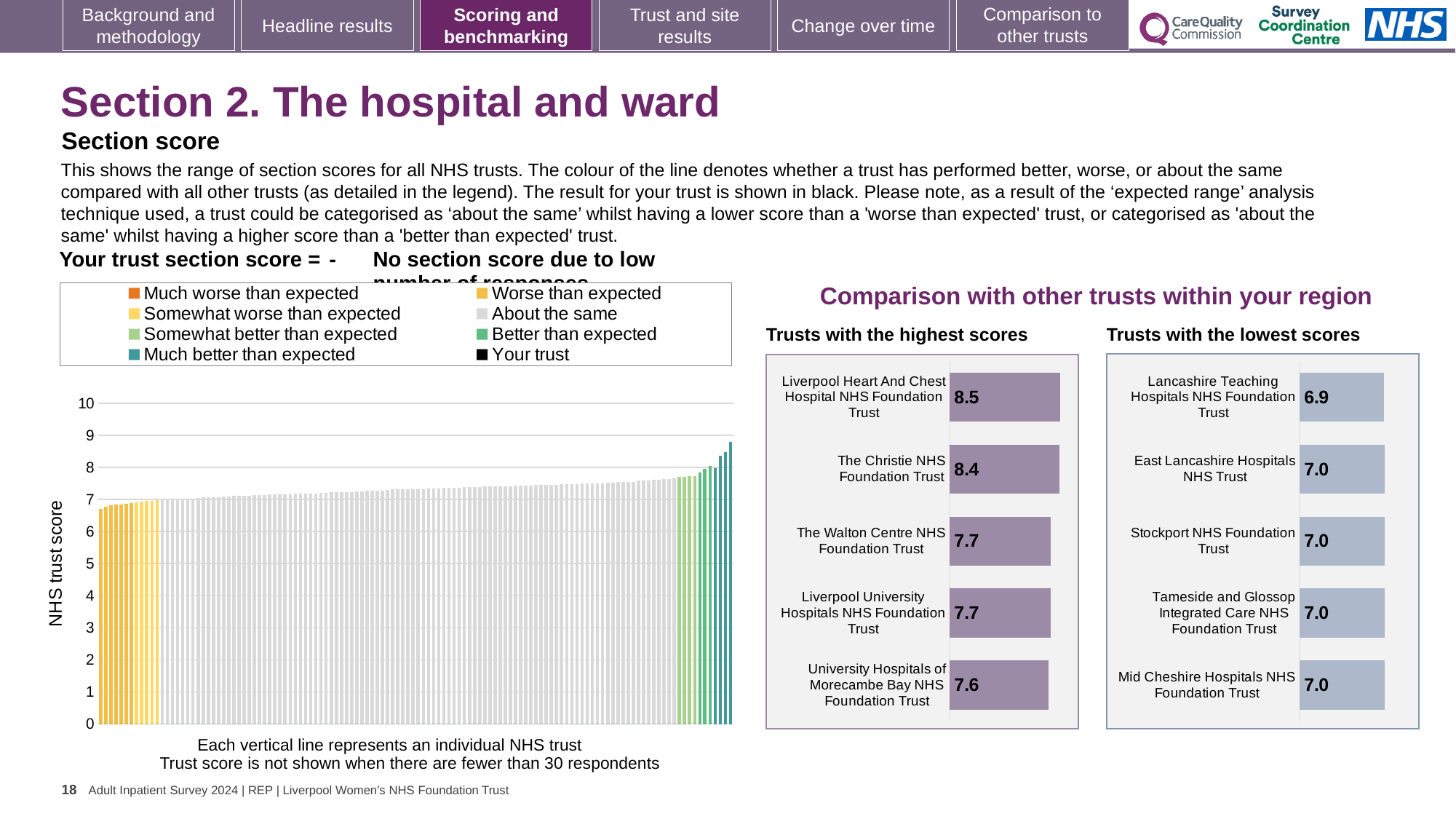
In the 'Trusts with the lowest scores' chart, which trust has the lowest score? Lancashire Teaching Hospitals NHS Foundation Trust In the 'Trusts with the lowest scores' chart, what is the score for Lancashire Teaching Hospitals NHS Foundation Trust? 6.9 In the 'Trusts with the highest scores' chart, which has the higher score: The Walton Centre NHS Foundation Trust or University Hospitals of Morecambe Bay NHS Foundation Trust? The Walton Centre NHS Foundation Trust What kind of chart is the 'Trusts with the highest scores' chart? Bar chart In the 'Trusts with the highest scores' chart, what is the score for Liverpool Heart And Chest Hospital NHS Foundation Trust? 8.5 In the 'Trusts with the highest scores' chart, what is the difference between the scores of Liverpool Heart And Chest Hospital NHS Foundation Trust and University Hospitals of Morecambe Bay NHS Foundation Trust? 0.9 In the 'Trusts with the highest scores' chart, what is the score for The Christie NHS Foundation Trust? 8.4 In the 'Trusts with the lowest scores' chart, what is the difference between the scores of East Lancashire Hospitals NHS Trust and Lancashire Teaching Hospitals NHS Foundation Trust? 0.1 In the 'Trusts with the highest scores' chart, which trust has the highest score? Liverpool Heart And Chest Hospital NHS Foundation Trust How many entries does the legend of the NHS trust score chart on the left list? 8 How many trusts are shown in the 'Trusts with the lowest scores' chart? 5 In the NHS trust score chart on the left, is the value of the tallest bar greater or less than 8? greater